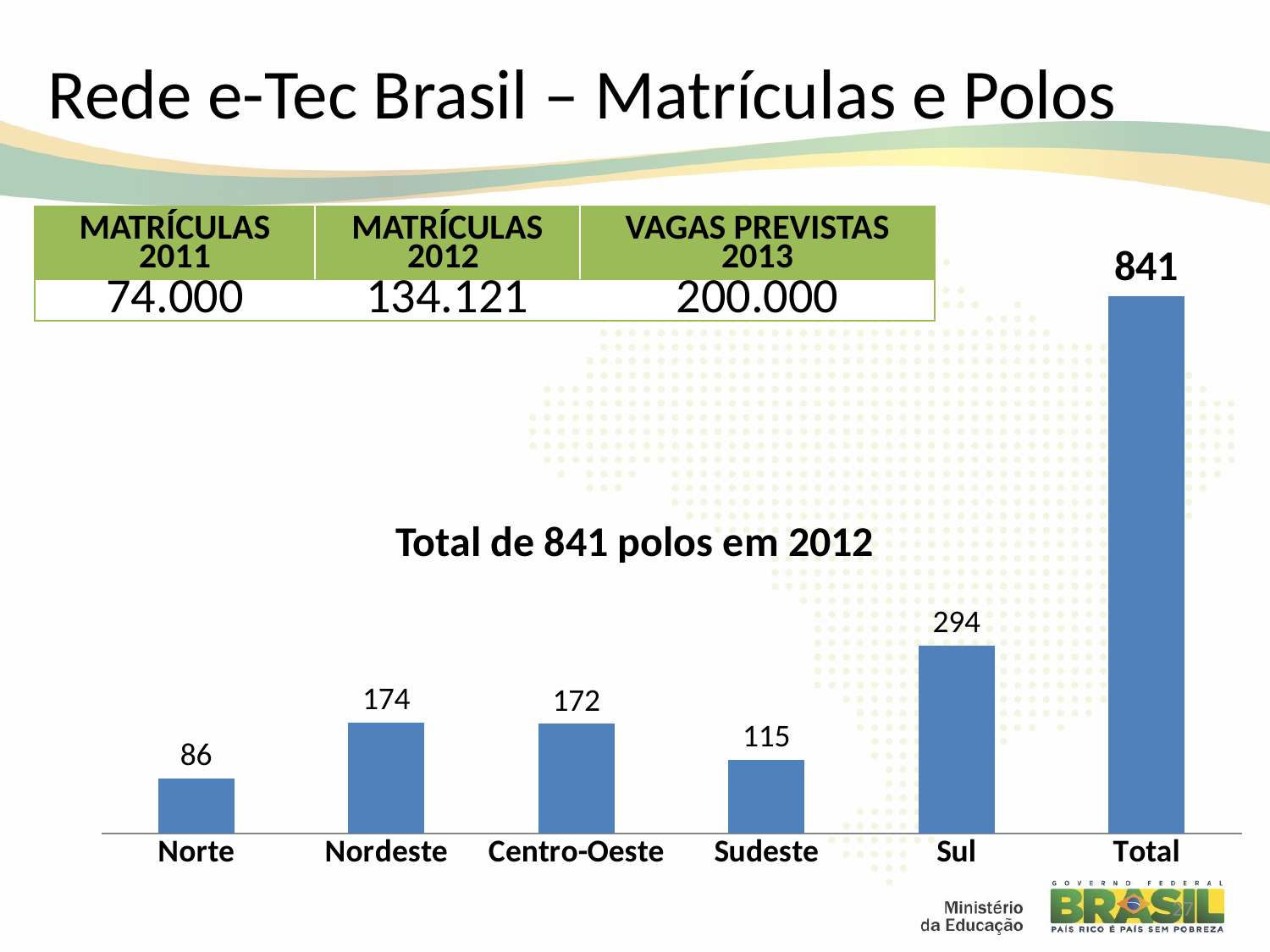
What is the difference between the values for Sul and Sudeste? 179 Which is larger, the value for Nordeste or the value for Sudeste? Nordeste What is the value for Sul in the bar chart? 294 What value is shown for the Total bar? 841 What kind of chart is shown on the slide? bar chart What is the difference between the values for Nordeste and Norte? 88 What is the value for Norte in the bar chart? 86 Excluding the Total bar, which region has the highest number of polos? Sul How many bars are shown in the bar chart? 6 What is the value for Centro-Oeste in the bar chart? 172 Which region has the lowest number of polos in the bar chart? Norte What is the value for Sudeste in the bar chart? 115